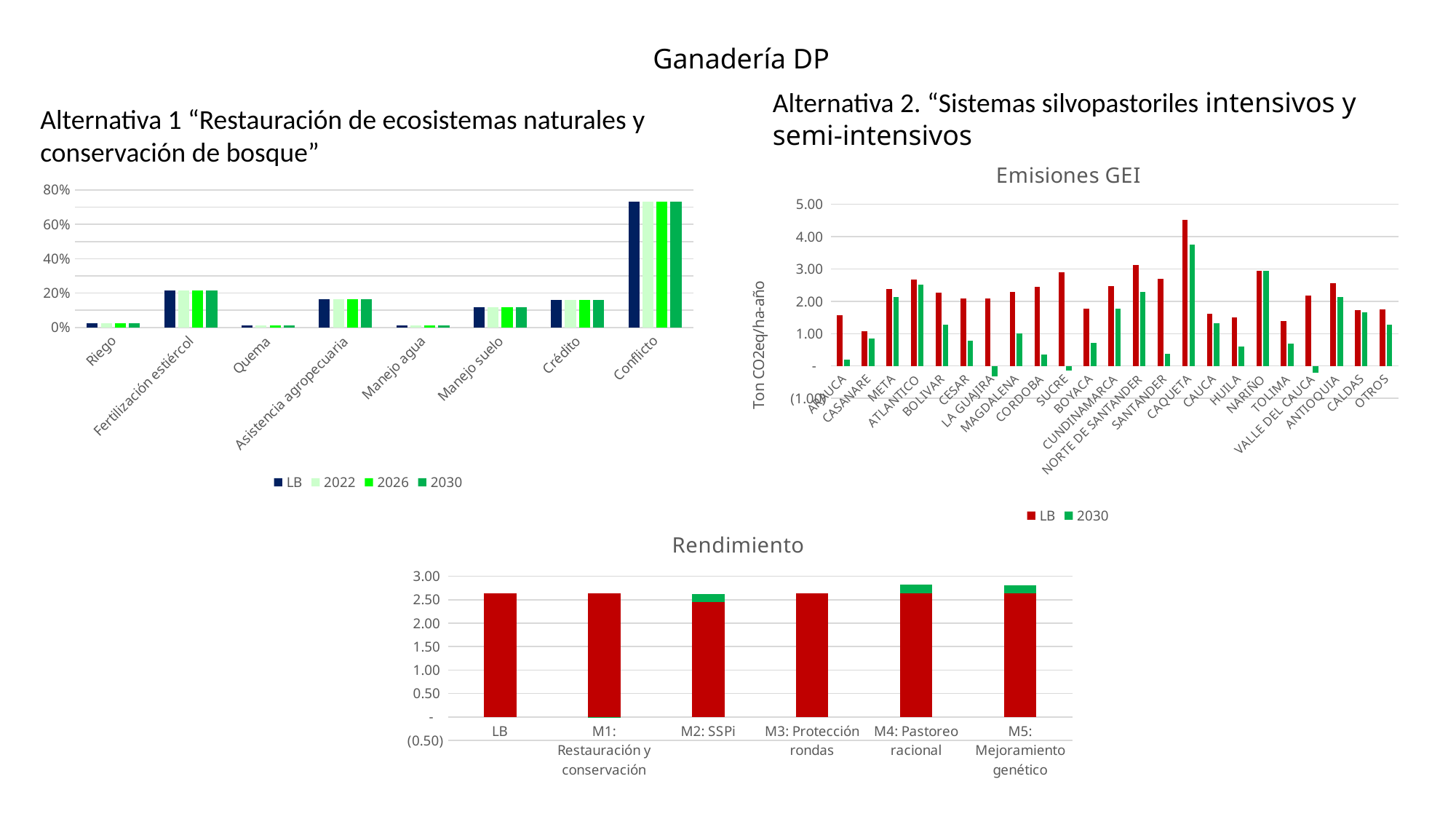
How many series does the legend of the Emisiones GEI chart list? 2 In the Emisiones GEI chart, which department has the highest LB value? CAQUETA In the Alternativa 1 chart, is the LB value for Fertilización estiércol greater or less than 40%? less In the Alternativa 1 chart, which is larger: the LB value for Asistencia agropecuaria or the LB value for Riego? Asistencia agropecuaria In the Emisiones GEI chart, which is larger: the LB value for META or the LB value for CASANARE? META In the Emisiones GEI chart, is the LB value for CAQUETA greater or less than 4.00? greater In the Alternativa 1 chart, is the LB value for Conflicto greater or less than 60%? greater What kind of chart is the Rendimiento chart? bar chart In the Alternativa 1 chart, which category has the highest values? Conflicto How many series does the legend of the Alternativa 1 chart list? 4 What is the y-axis label of the Emisiones GEI chart? Ton CO2eq/ha-año How many categories are shown on the x axis of the Alternativa 1 chart? 8